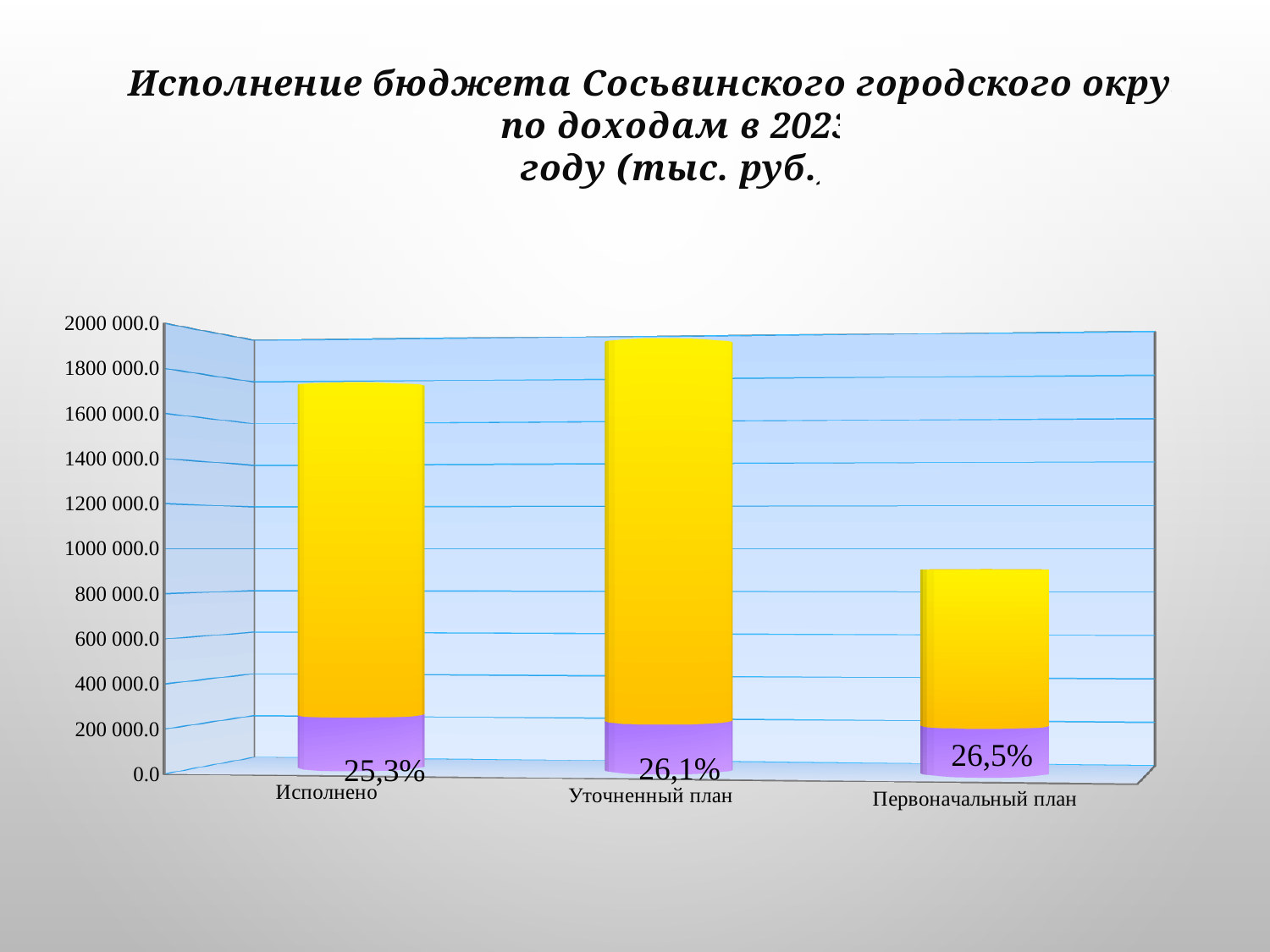
Is the total value for Уточненный план greater or less than 1800 000.0? greater Is the total value for Исполнено greater or less than 1600 000.0? greater What percentage label is printed at the base of the Исполнено bar? 25,3% Which bar is taller: Уточненный план or Исполнено? Уточненный план Is the total value for Первоначальный план greater or less than 1000 000.0? less Which category has the tallest bar in the chart? Уточненный план What percentage label is printed at the base of the Первоначальный план bar? 26,5% What kind of chart is shown on the slide? Bar chart Which category has the shortest bar in the chart? Первоначальный план Which bar is taller: Исполнено or Первоначальный план? Исполнено How many categories are shown on the x axis of the chart? 3